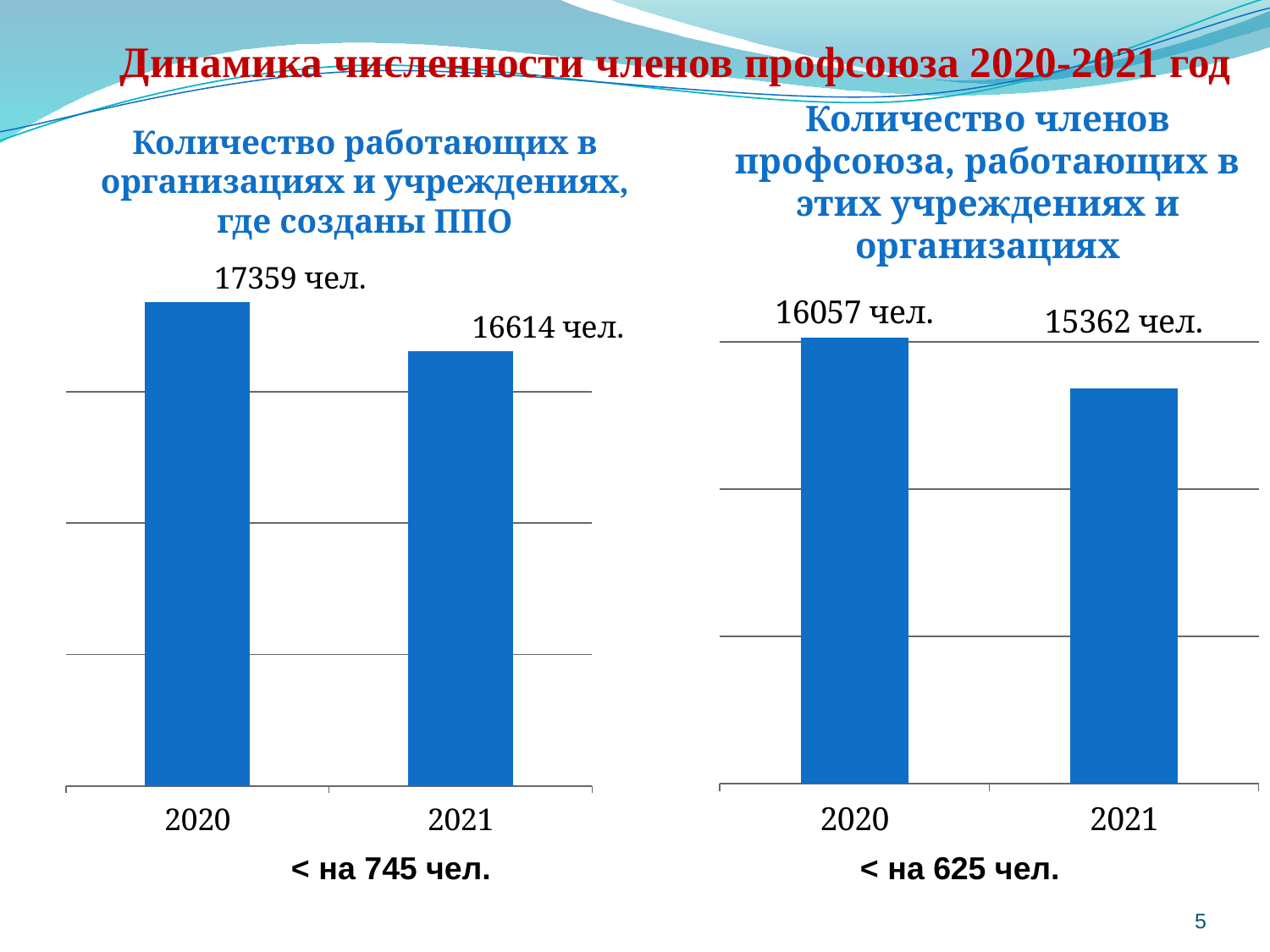
In the right chart, what is the difference between the 2020 and 2021 values? 625 чел. How many categories does the left chart show? 2 In the left chart, which year has the higher value? 2020 In the left chart (Количество работающих в организациях и учреждениях, где созданы ППО), what is the value for 2021? 16614 чел. In the right chart (Количество членов профсоюза, работающих в этих учреждениях и организациях), what is the value for 2021? 15362 чел. In the right chart, which year has the lower value? 2021 In the right chart, is the value for 2020 larger or smaller than the value for 2021? larger What type of chart is the right chart? bar chart In the left chart, do the values rise or fall from 2020 to 2021? fall In the left chart (Количество работающих в организациях и учреждениях, где созданы ППО), what is the value for 2020? 17359 чел. In the right chart (Количество членов профсоюза, работающих в этих учреждениях и организациях), what is the value for 2020? 16057 чел. In the left chart, what is the difference between the 2020 and 2021 values? 745 чел.